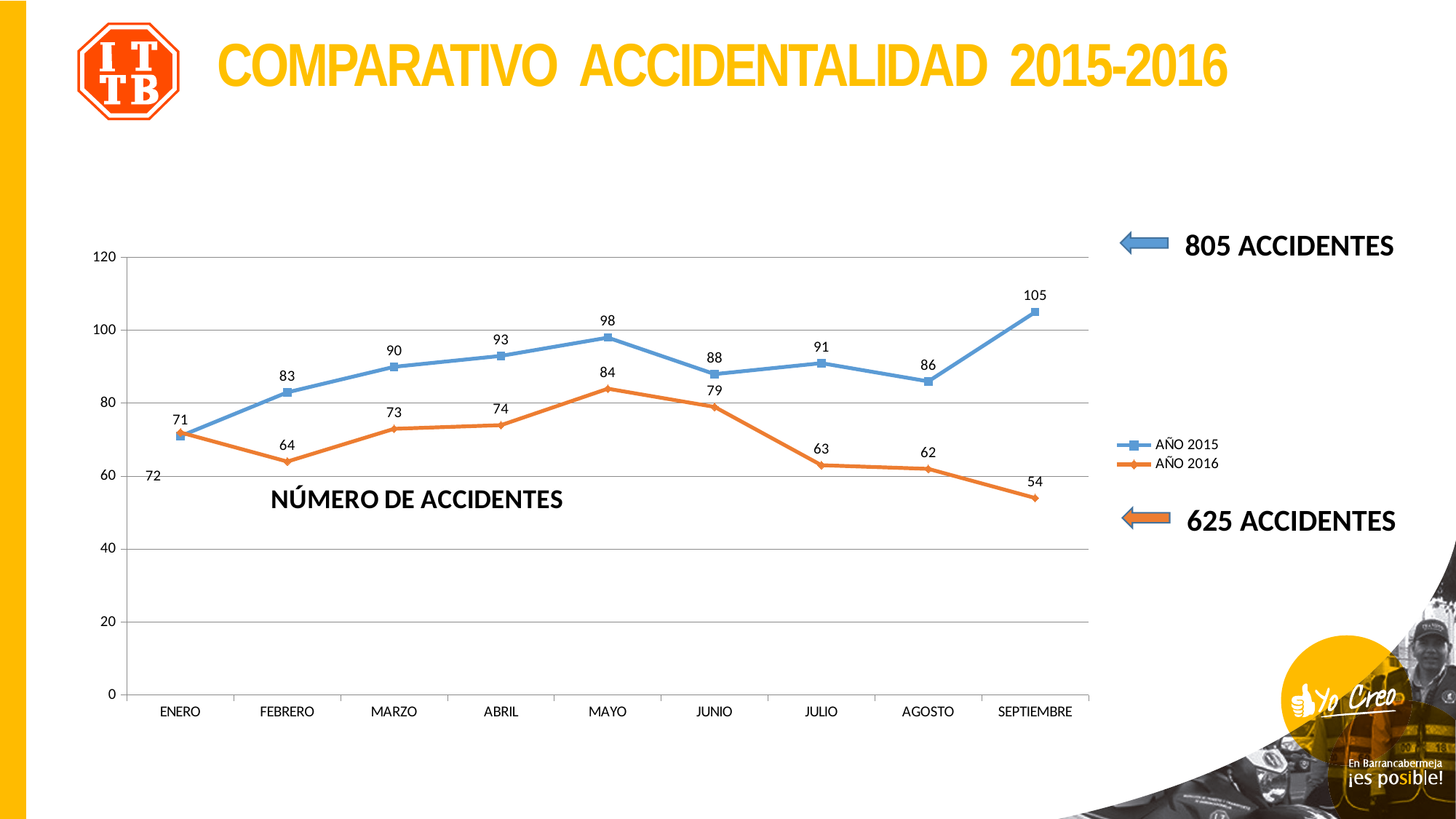
How many series does the legend list? 2 Which series has the larger value in JULIO, AÑO 2015 or AÑO 2016? AÑO 2015 What total number of accidents is shown next to the blue arrow for AÑO 2015? 805 ACCIDENTES In which month is the AÑO 2015 value highest? SEPTIEMBRE What kind of chart is shown on the slide? line chart What is the value for AÑO 2016 in MAYO? 84 What is the difference between AÑO 2015 and AÑO 2016 in SEPTIEMBRE? 51 What is the value for AÑO 2015 in SEPTIEMBRE? 105 In which month is the AÑO 2016 value lowest? SEPTIEMBRE How many months are plotted along the x axis? 9 From MAYO to SEPTIEMBRE, do the AÑO 2016 values rise or fall? fall What is the value for AÑO 2016 in ENERO? 72